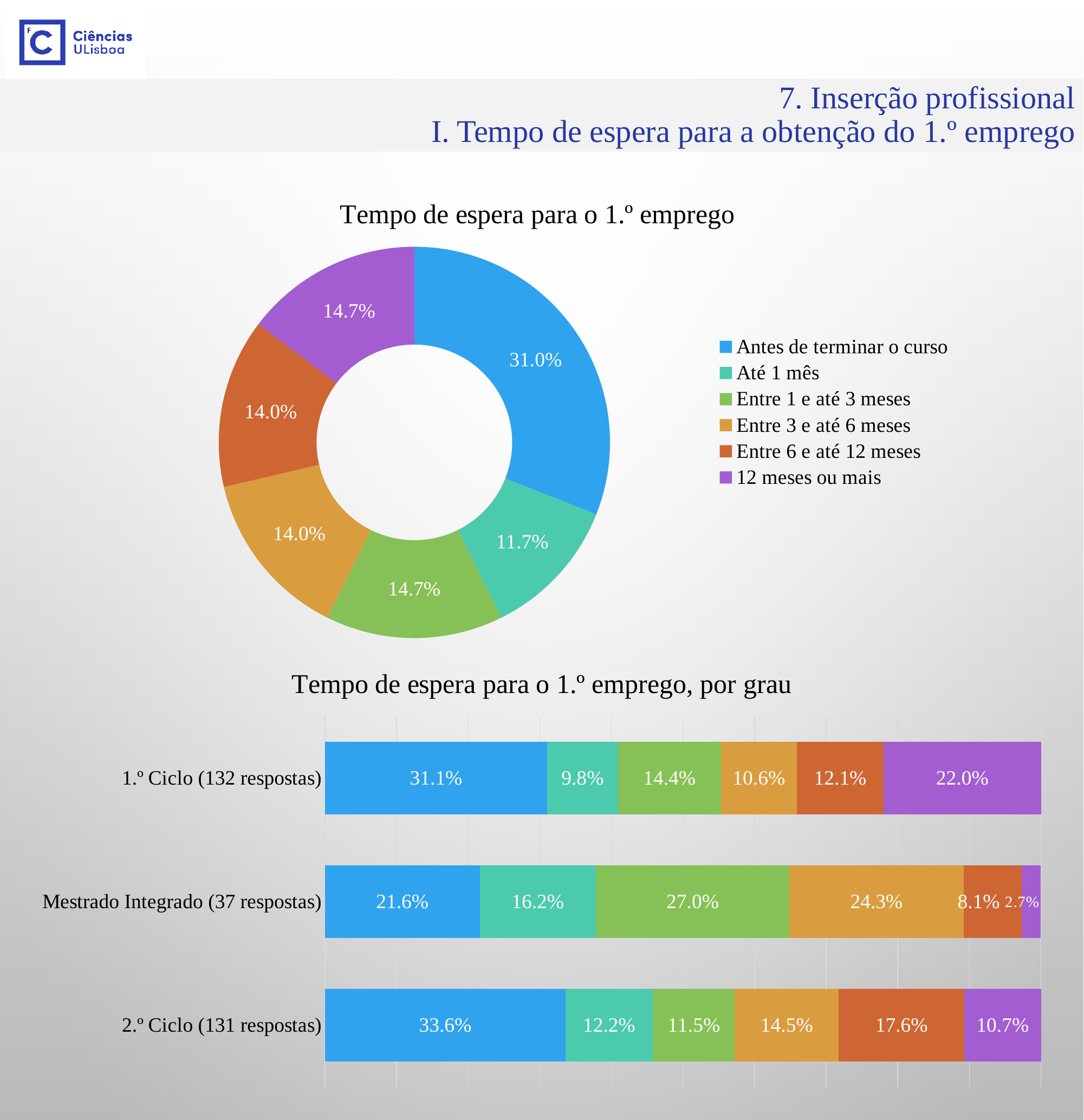
In the chart 'Tempo de espera para o 1.º emprego, por grau', what is the difference between the blue segment of '2.º Ciclo (131 respostas)' and the blue segment of 'Mestrado Integrado (37 respostas)'? 12.0% In the chart 'Tempo de espera para o 1.º emprego', what share is shown for 'Antes de terminar o curso'? 31.0% In the chart 'Tempo de espera para o 1.º emprego, por grau', what is the value of the last (purple) segment for '1.º Ciclo (132 respostas)'? 22.0% In the chart 'Tempo de espera para o 1.º emprego', which category has the smallest share? Até 1 mês In the chart 'Tempo de espera para o 1.º emprego, por grau', what is the value of the green segment for 'Mestrado Integrado (37 respostas)'? 27.0% In the chart 'Tempo de espera para o 1.º emprego, por grau', how many bars (degree categories) are shown? 3 In the chart 'Tempo de espera para o 1.º emprego', what share is shown for 'Até 1 mês'? 11.7% What kind of chart is 'Tempo de espera para o 1.º emprego'? Doughnut chart In the chart 'Tempo de espera para o 1.º emprego, por grau', which is larger: the purple segment for '1.º Ciclo (132 respostas)' or the purple segment for '2.º Ciclo (131 respostas)'? 1.º Ciclo (132 respostas) In the chart 'Tempo de espera para o 1.º emprego, por grau', what is the value of the first (blue) segment for '2.º Ciclo (131 respostas)'? 33.6% How many entries does the legend of the chart 'Tempo de espera para o 1.º emprego' list? 6 In the chart 'Tempo de espera para o 1.º emprego', which category has the largest share? Antes de terminar o curso